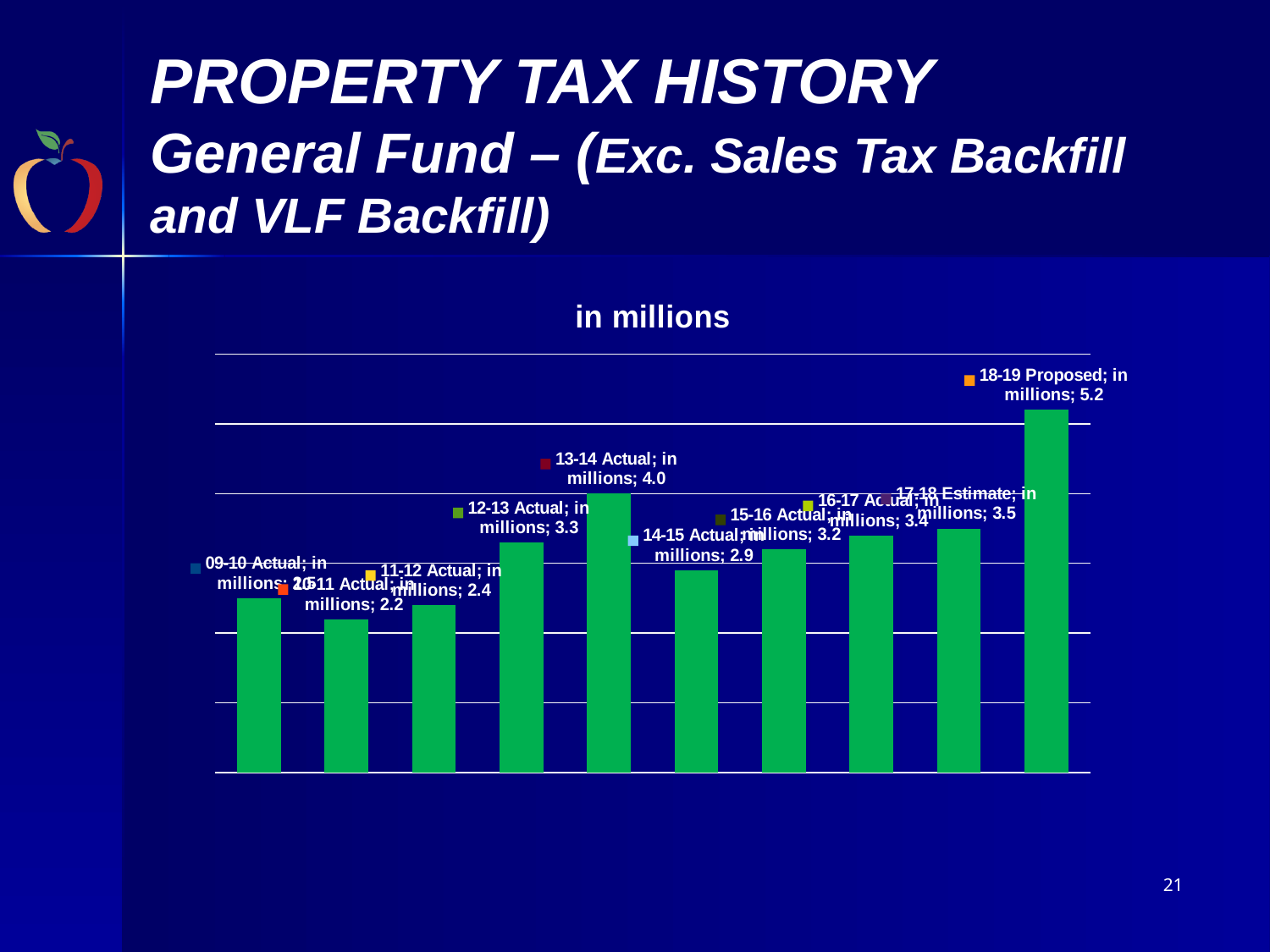
Do the values rise or fall from 14-15 Actual through 18-19 Proposed? Rise Which category has the highest value? 18-19 Proposed What is the difference between the 18-19 Proposed value and the 13-14 Actual value? 1.2 What is the value for 17-18 Estimate? 3.5 What is the difference between the 13-14 Actual value and the 12-13 Actual value? 0.7 What is the value for 18-19 Proposed? 5.2 What is the value for 10-11 Actual? 2.2 What is the value for 13-14 Actual? 4.0 What kind of chart is shown on the slide? Bar chart Which category has the lowest value? 10-11 Actual Which is larger, the value for 14-15 Actual or 15-16 Actual? 15-16 Actual How many bars are shown in the chart? 10